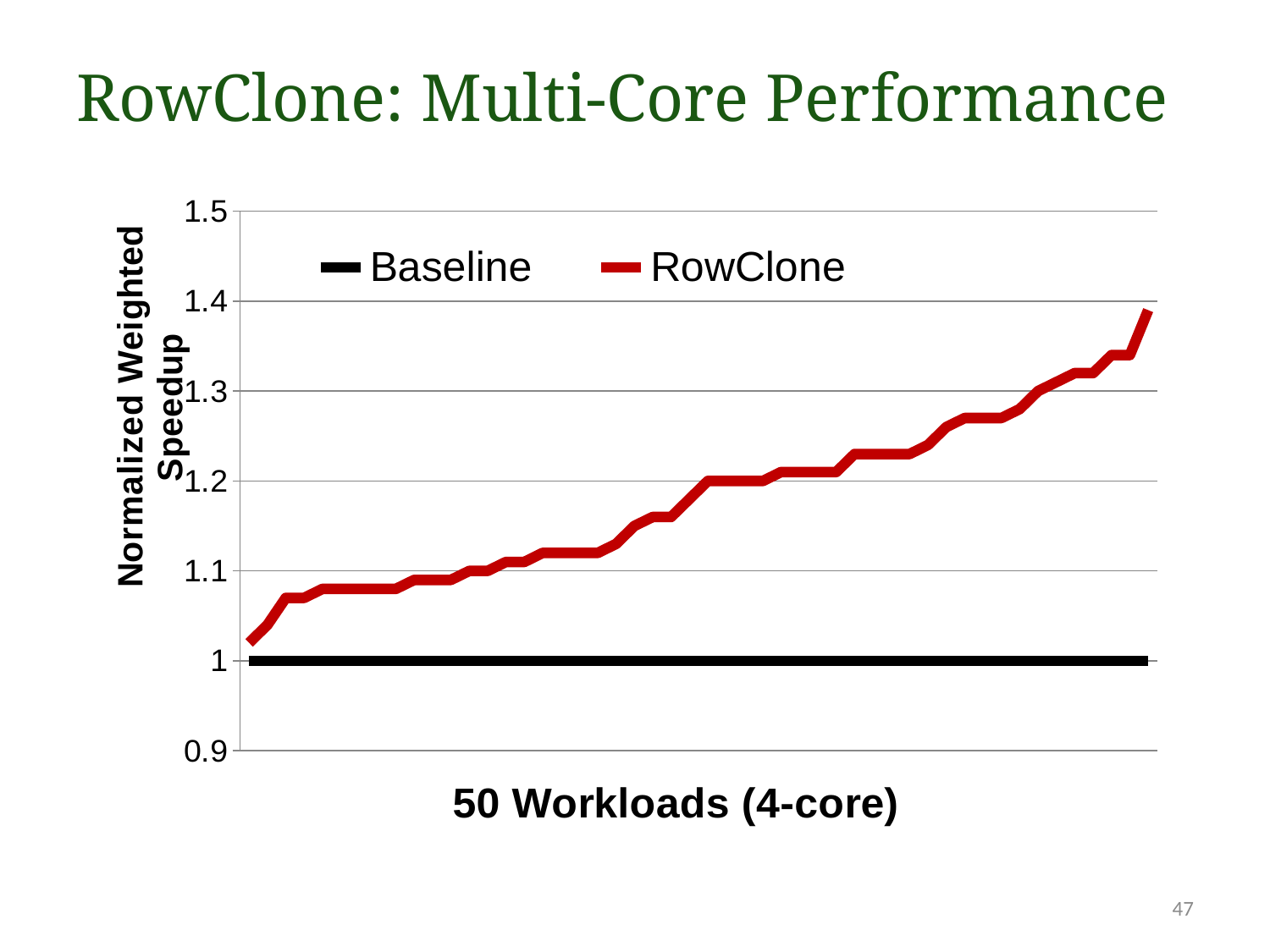
What are the two series named in the legend? Baseline and RowClone Is the highest RowClone value greater or less than 1.3? greater Does the RowClone series rise or fall from left to right along the x axis? rise Which series is drawn in red? RowClone Which series has the higher values across the workloads, Baseline or RowClone? RowClone What is the title of the chart's x axis? 50 Workloads (4-core) How many workloads are plotted along the x axis? 50 What kind of chart is shown on the slide? line chart What is the value of the Baseline series across the workloads? 1 Is the lowest RowClone value greater or less than 1.1? less How many series does the legend list? 2